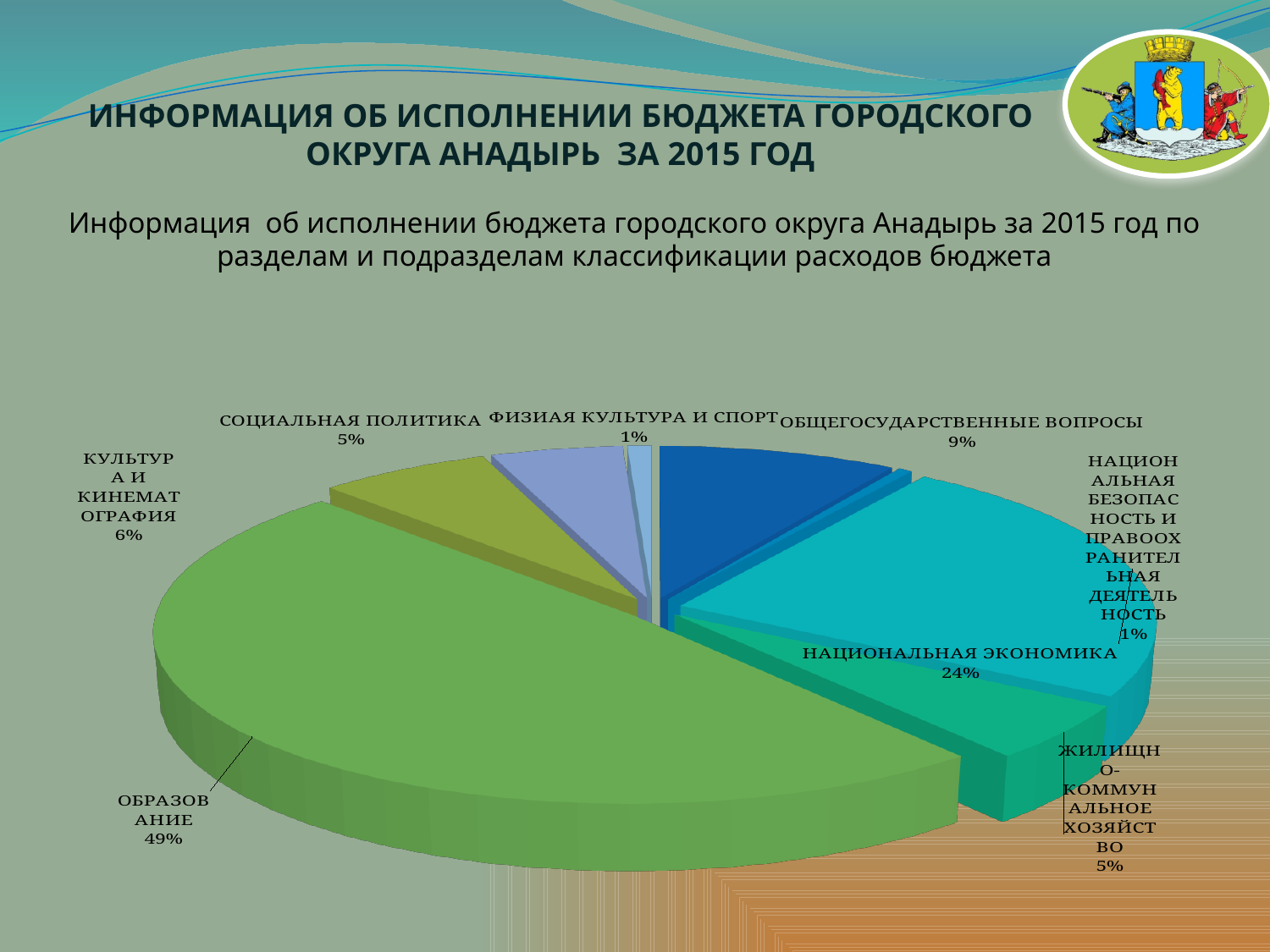
What percentage is shown for ОБЩЕГОСУДАРСТВЕННЫЕ ВОПРОСЫ? 9% Which category has the largest slice of the pie? ОБРАЗОВАНИЕ What share of the budget expenditure goes to ОБРАЗОВАНИЕ? 49% How many categories (slices) does the pie chart have? 8 What percentage is shown for НАЦИОНАЛЬНАЯ ЭКОНОМИКА? 24% Which year does the budget execution information on the slide refer to? 2015 Which is larger, the share for ОБЩЕГОСУДАРСТВЕННЫЕ ВОПРОСЫ or the share for ЖИЛИЩНО-КОММУНАЛЬНОЕ ХОЗЯЙСТВО? ОБЩЕГОСУДАРСТВЕННЫЕ ВОПРОСЫ What percentage is shown for СОЦИАЛЬНАЯ ПОЛИТИКА? 5% What type of chart is shown on the slide? pie chart What is the difference in percentage points between ОБРАЗОВАНИЕ and НАЦИОНАЛЬНАЯ ЭКОНОМИКА? 25 What is the combined share of СОЦИАЛЬНАЯ ПОЛИТИКА and ЖИЛИЩНО-КОММУНАЛЬНОЕ ХОЗЯЙСТВО? 10% What percentage is shown for КУЛЬТУРА И КИНЕМАТОГРАФИЯ? 6%